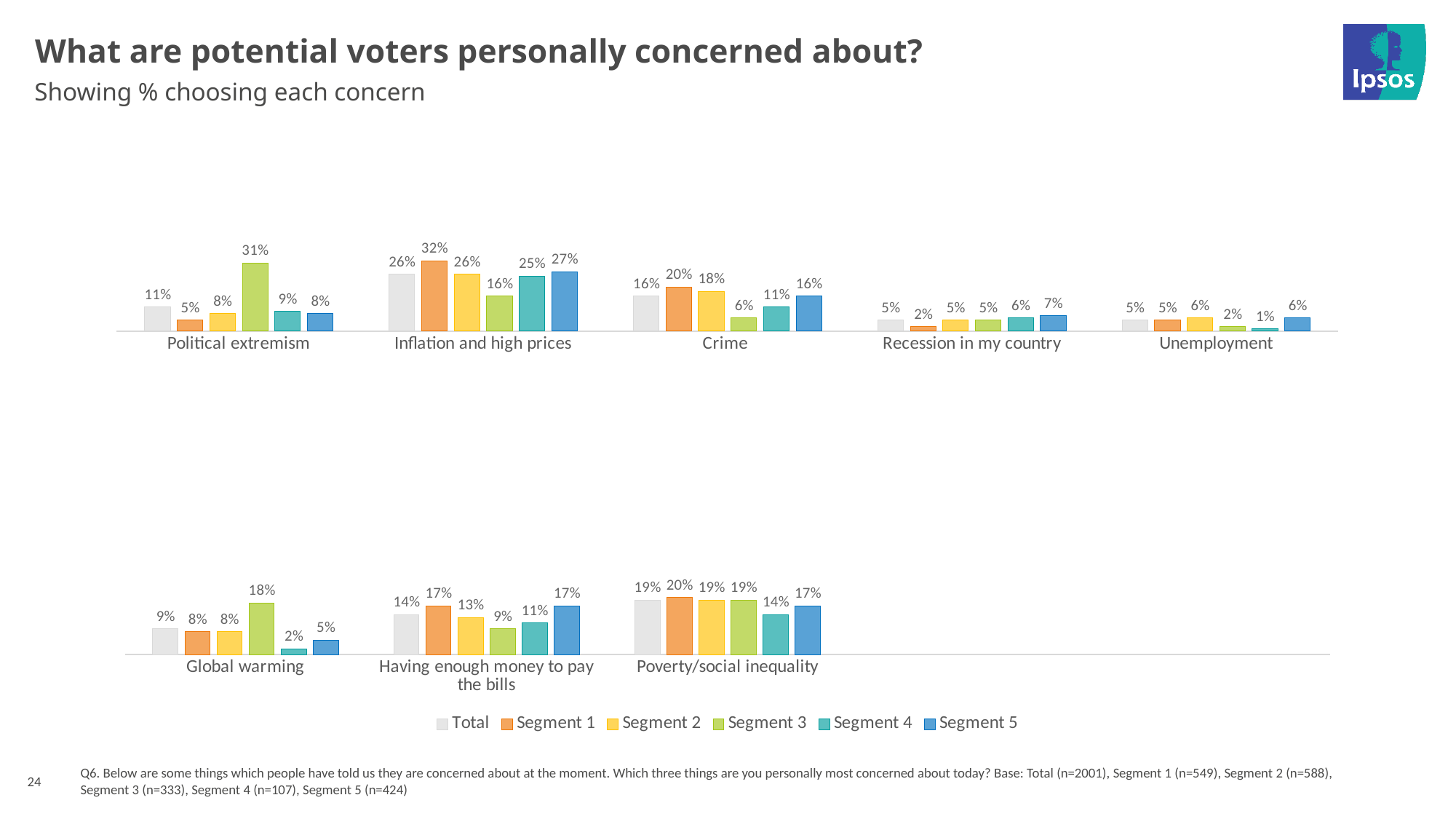
What kind of chart is the top chart? Bar chart In the bottom chart, what is the difference between the Segment 3 and Segment 4 values for Global warming? 16% In the top chart, which segment has the highest value for Crime? Segment 1 How many categories are shown in the bottom chart? 3 In the top chart, which segment has the lowest value for Unemployment? Segment 4 In the bottom chart, which is larger for Having enough money to pay the bills: Segment 1 or Segment 2? Segment 1 How many categories are shown in the top chart? 5 In the top chart, what is the Segment 3 value for Political extremism? 31% In the top chart, what is the difference between the Segment 5 and Segment 1 values for Recession in my country? 5% How many series does the legend list? 6 In the top chart, what is the Segment 1 value for Inflation and high prices? 32% In the bottom chart, what is the Total value for Poverty/social inequality? 19%